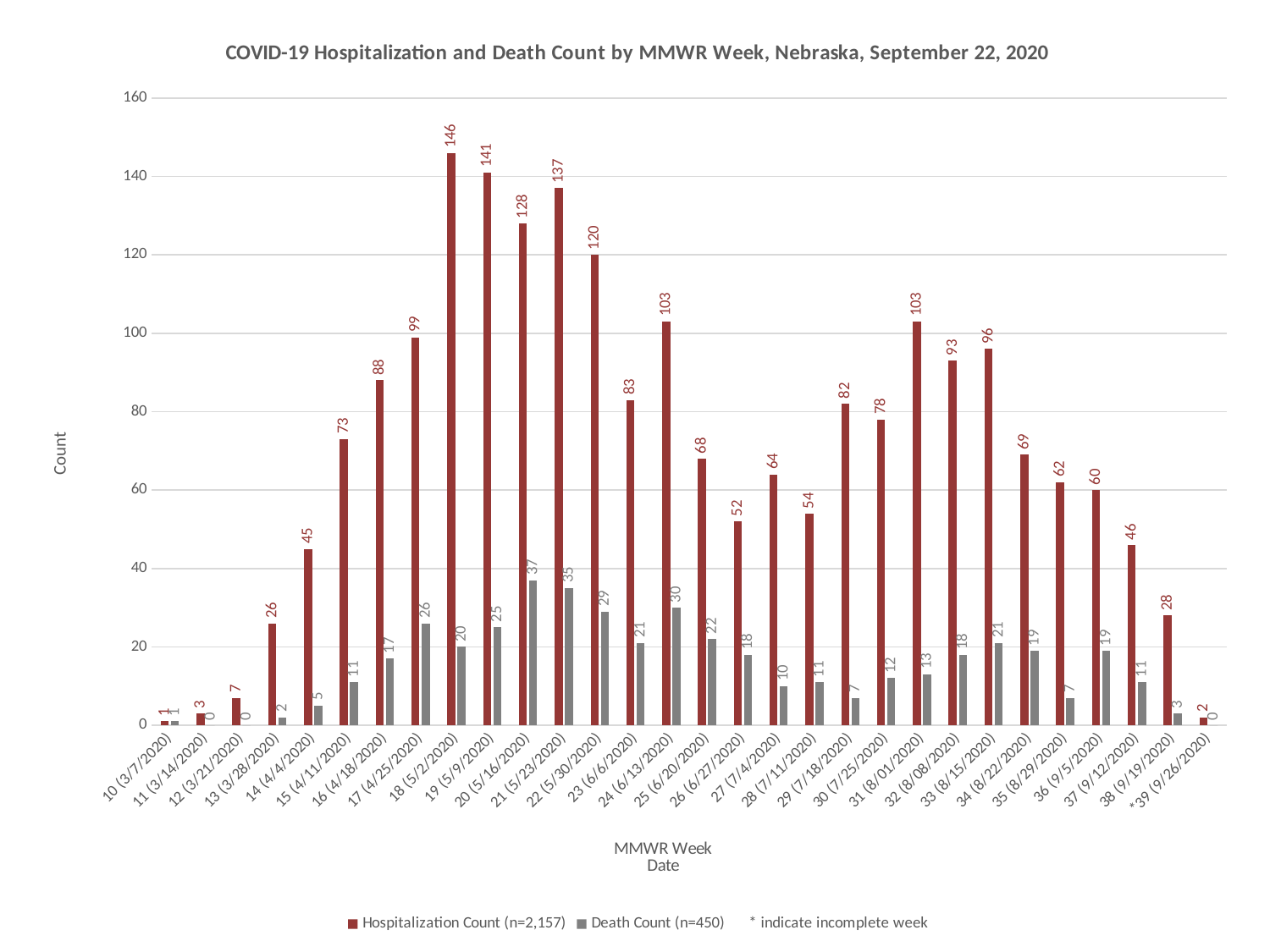
Does the Hospitalization Count rise or fall from week 10 (3/7/2020) to week 18 (5/2/2020)? Rise Which MMWR week has the lowest Hospitalization Count? 10 (3/7/2020) What kind of chart is this? Bar chart What is the difference between the Hospitalization Count for week 18 (5/2/2020) and week 19 (5/9/2020)? 5 How many MMWR weeks are shown on the x axis? 30 What is the Death Count for MMWR week 24 (6/13/2020)? 30 What is the Hospitalization Count for MMWR week 18 (5/2/2020)? 146 What is the combined Hospitalization Count and Death Count for week 20 (5/16/2020)? 165 Which MMWR week has the highest Death Count? 20 (5/16/2020) Which MMWR week has the highest Hospitalization Count? 18 (5/2/2020) How many series does the legend list? 2